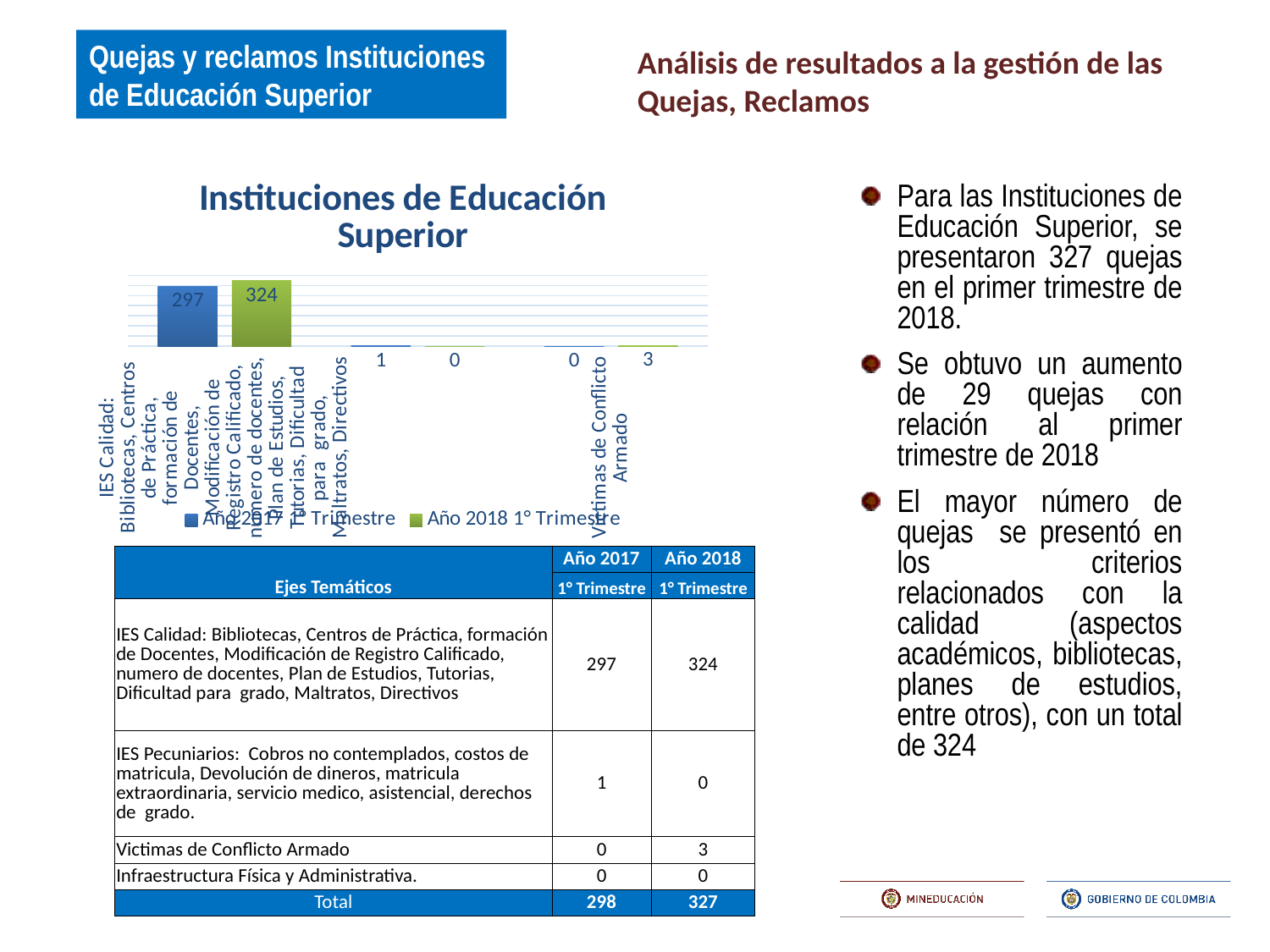
In the 'Instituciones de Educación Superior' chart, by how much does the 'Año 2018 1° Trimestre' value exceed the 'Año 2017 1° Trimestre' value for the IES Calidad category? 27 Which series is shown in green in the 'Instituciones de Educación Superior' chart? Año 2018 1° Trimestre What is the title of the chart on the slide? Instituciones de Educación Superior In the 'Instituciones de Educación Superior' chart, what is the difference between the 'Año 2018 1° Trimestre' and 'Año 2017 1° Trimestre' values for Victimas de Conflicto Armado? 3 In the 'Instituciones de Educación Superior' chart, what is the value of 'Año 2017 1° Trimestre' for Victimas de Conflicto Armado? 0 In the 'Instituciones de Educación Superior' chart, which category has the highest 'Año 2018 1° Trimestre' value? IES Calidad: Bibliotecas, Centros de Práctica, formación de Docentes, Modificación de Registro Calificado, numero de docentes, Plan de Estudios, Tutorias, Dificultad para grado, Maltratos, Directivos In the 'Instituciones de Educación Superior' chart, what is the value of 'Año 2018 1° Trimestre' for the IES Calidad category? 324 In the 'Instituciones de Educación Superior' chart, what is the value of 'Año 2018 1° Trimestre' for Victimas de Conflicto Armado? 3 What kind of chart is shown under the title 'Instituciones de Educación Superior'? bar chart In the 'Instituciones de Educación Superior' chart, what is the value of 'Año 2017 1° Trimestre' for the IES Calidad category? 297 In the 'Instituciones de Educación Superior' chart, which series has the larger value for the IES Calidad category? Año 2018 1° Trimestre How many series does the legend of the 'Instituciones de Educación Superior' chart list? 2